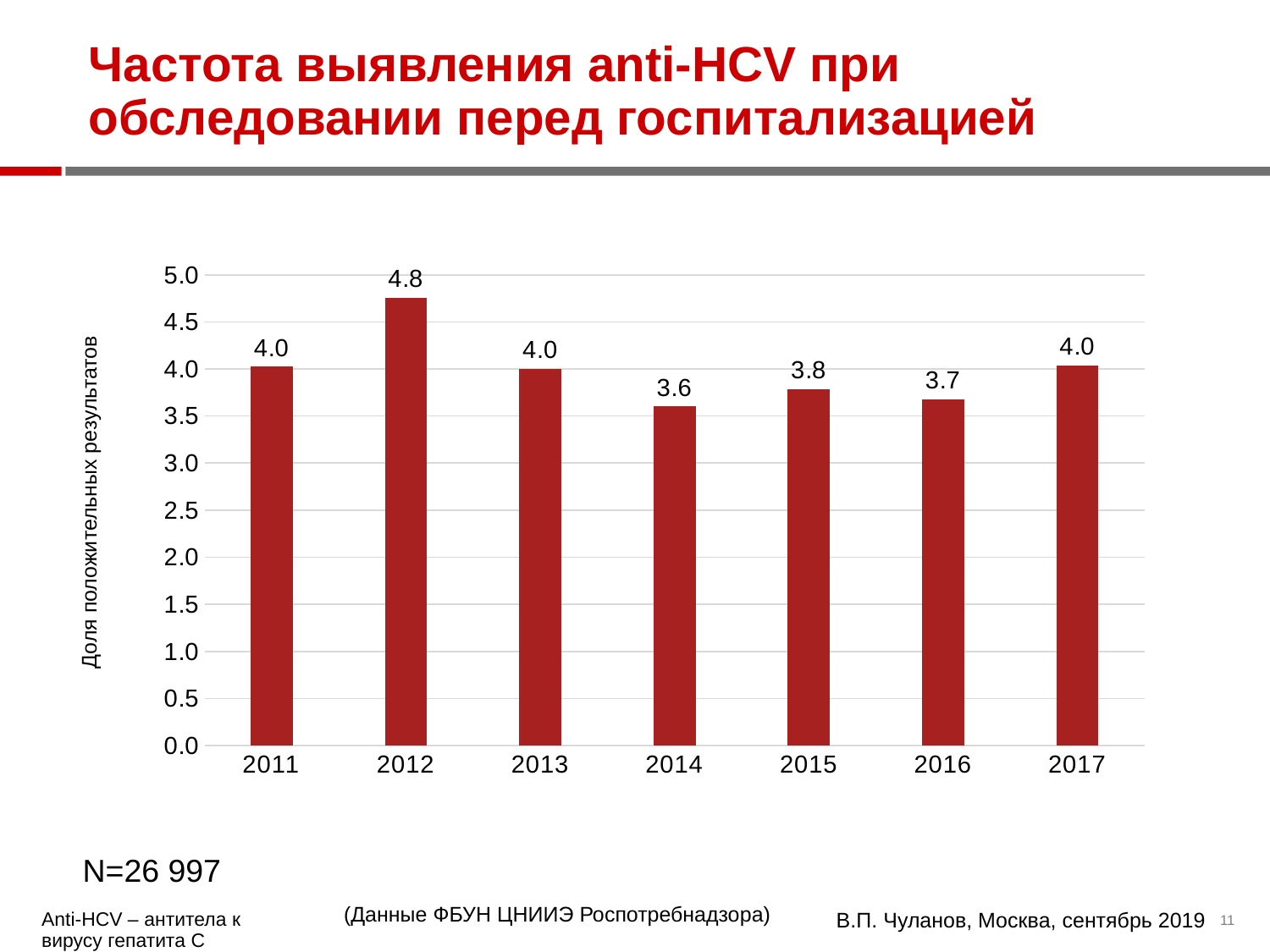
What is the value for 2014? 3.6 How many years are shown on the x axis? 7 Which is larger, the value for 2015 or the value for 2016? 2015 What is the label of the y axis? Доля положительных результатов Which year has the lowest value? 2014 What is the value for 2016? 3.7 Is the value for 2012 greater or less than 4.5? greater What is the value for 2012? 4.8 What is the value for 2015? 3.8 What is the difference between the values for 2012 and 2014? 1.2 Which year has the highest value? 2012 What kind of chart is shown on the slide? bar chart